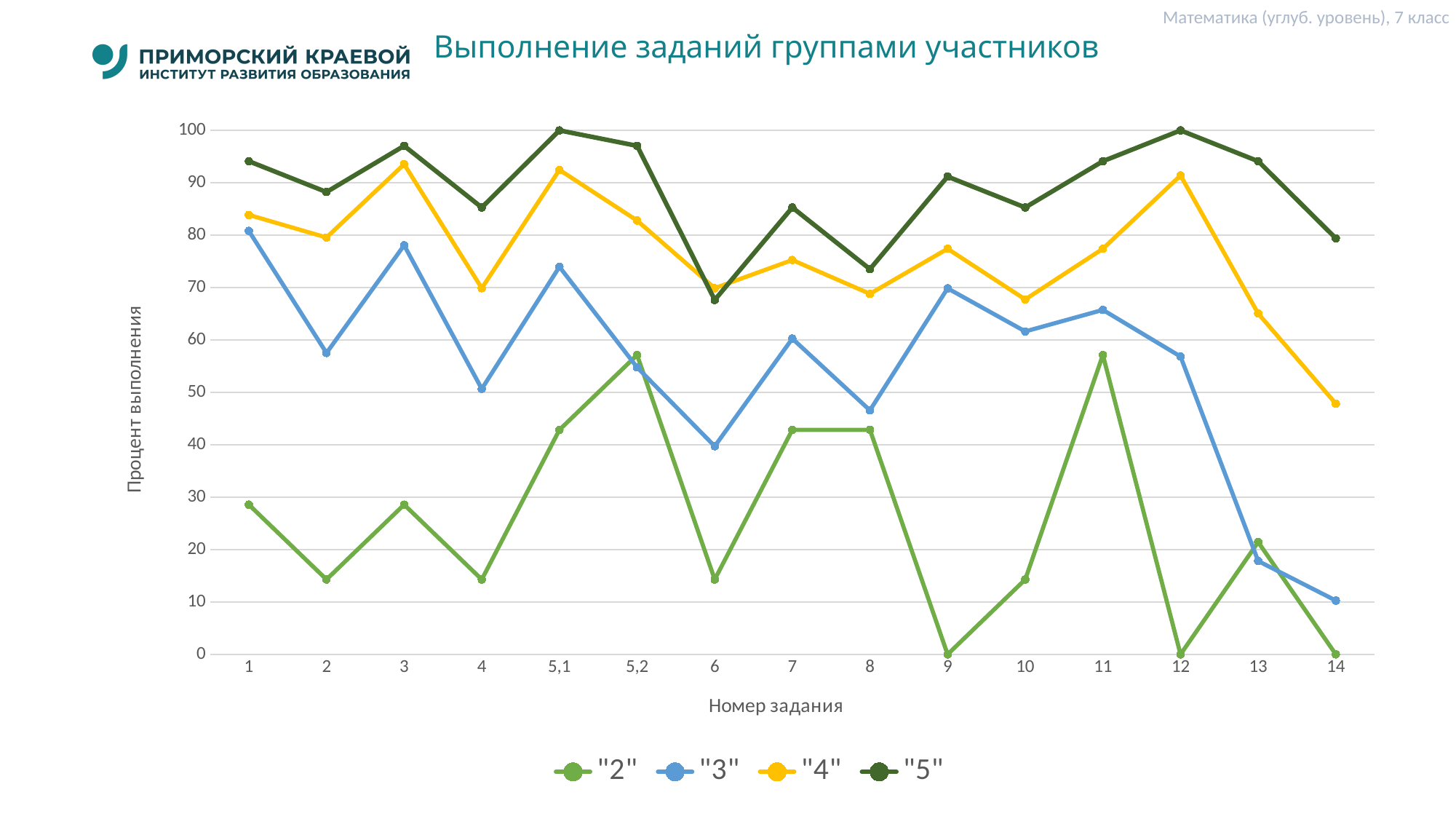
Is the value for series "4" at task 3 greater or less than 90? greater What kind of chart is shown on the slide? line chart At which task number does series "3" reach its lowest value? 14 How many series does the legend list? 4 Is the value for series "2" at task 11 greater or less than 50? greater How many task numbers are shown on the x axis? 15 What is the value for series "2" at task 9? 0 At task 12, which series has the larger value: "3" or "4"? "4" Is the value for series "3" at task 3 greater or less than 80? less What is the value for series "5" at task 5,1? 100 At which task number does series "5" reach its lowest value? 6 What is the value for series "5" at task 12? 100